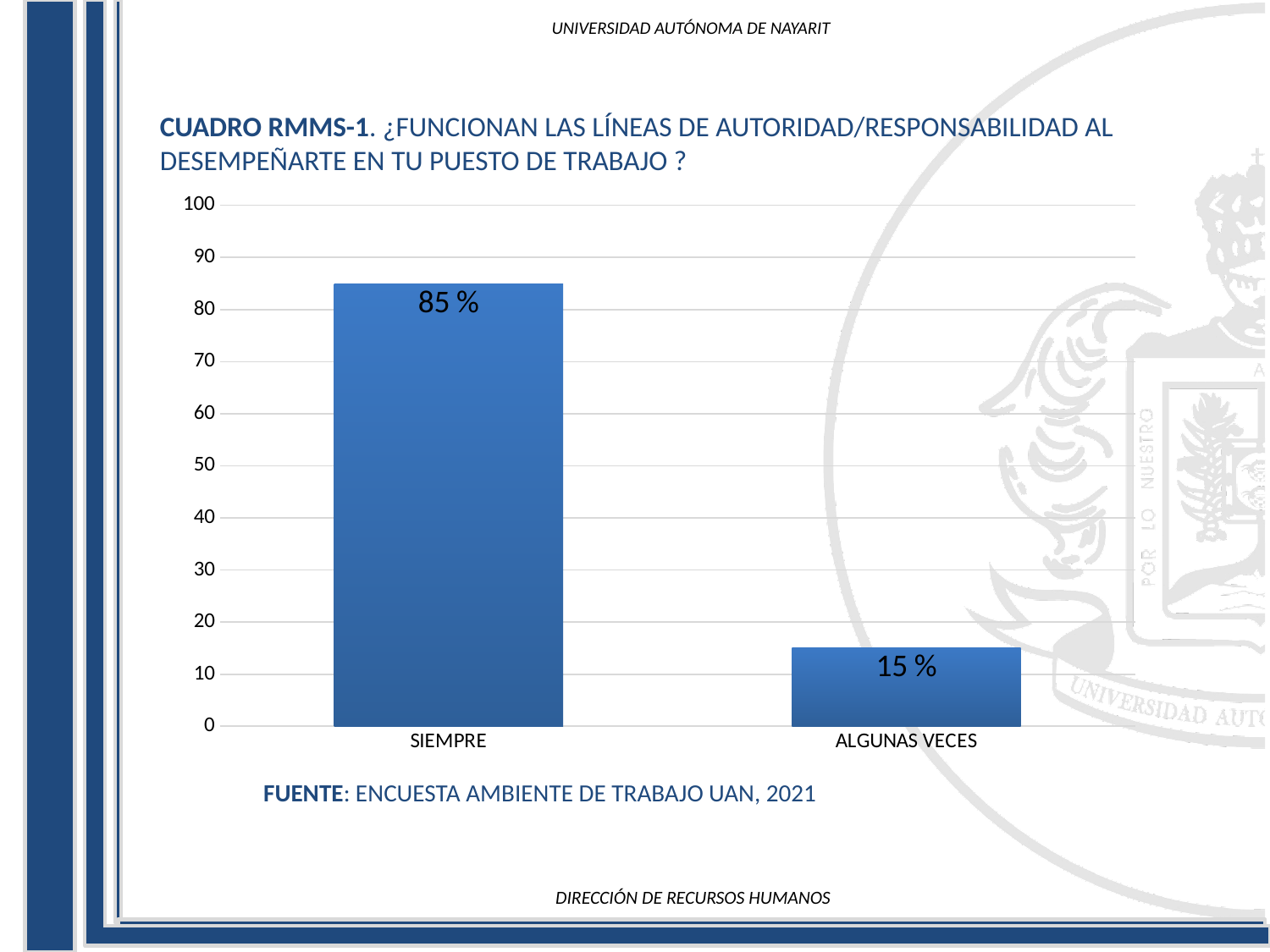
What is the value for ALGUNAS VECES? 15 % What kind of chart is shown on the slide? bar chart Is the value for SIEMPRE greater or less than 80? greater What is the value for SIEMPRE? 85 % How many categories are shown on the chart? 2 What is the total of the two values shown on the chart? 100 % Is the value for ALGUNAS VECES greater or less than 20? less What source is cited below the chart? ENCUESTA AMBIENTE DE TRABAJO UAN, 2021 Which category has the lowest value? ALGUNAS VECES Which category has the highest value? SIEMPRE What is the difference between the values for SIEMPRE and ALGUNAS VECES? 70 % Which is larger, the value for SIEMPRE or the value for ALGUNAS VECES? SIEMPRE